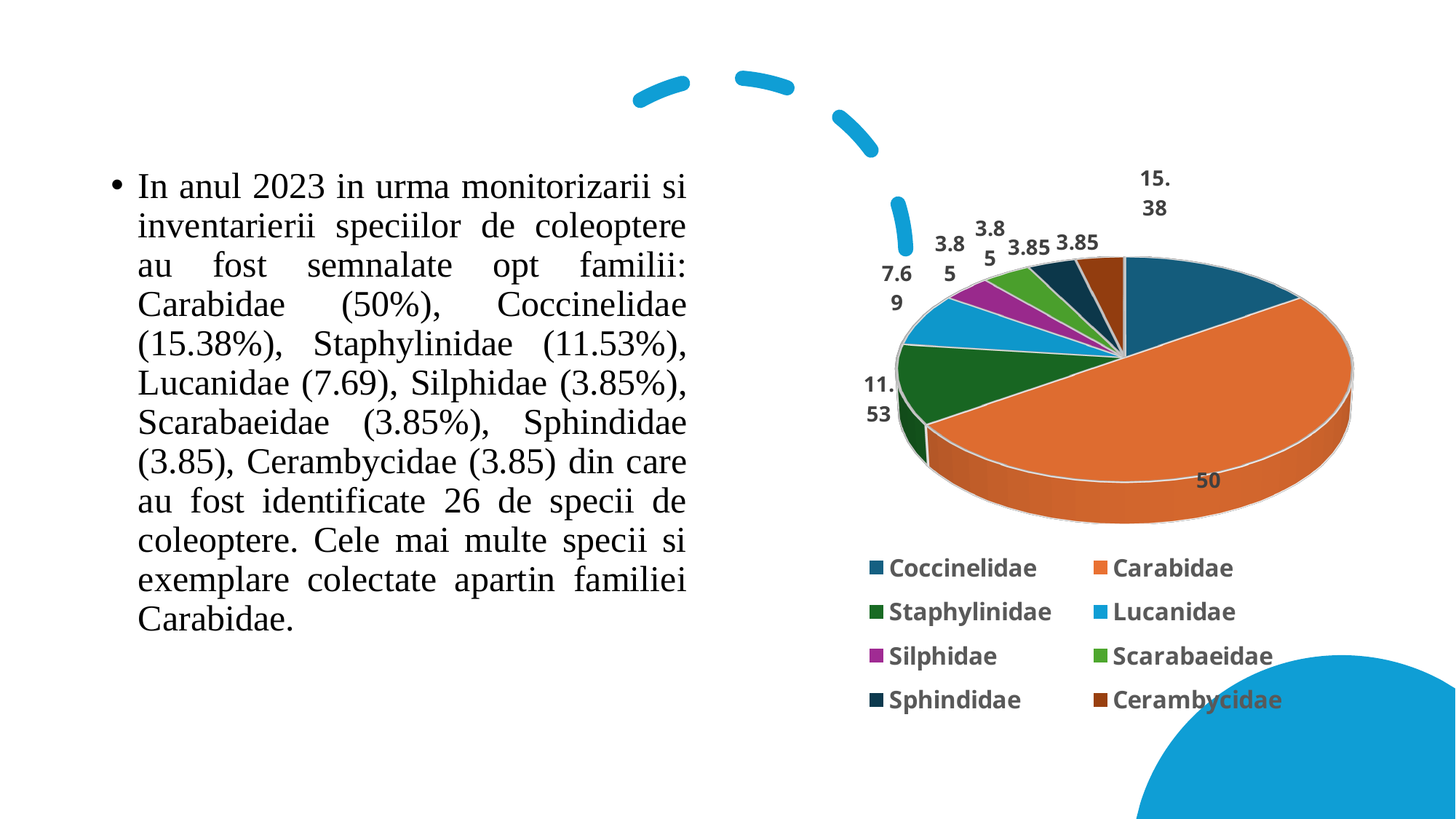
Which has a larger value in the pie chart, Staphylinidae or Lucanidae? Staphylinidae What is the value shown for Silphidae in the pie chart? 3.85 What is the value shown for Lucanidae in the pie chart? 7.69 How many slices does the pie chart have? 8 What is the difference between the values for Carabidae and Coccinelidae in the pie chart? 34.62 What kind of chart is shown on the slide? Pie chart How many entries does the legend of the pie chart list? 8 Which family has the largest slice in the pie chart? Carabidae What is the value shown for Coccinelidae in the pie chart? 15.38 What colour is the Carabidae slice in the pie chart? Orange What is the value shown for Carabidae in the pie chart? 50 What is the value shown for Staphylinidae in the pie chart? 11.53